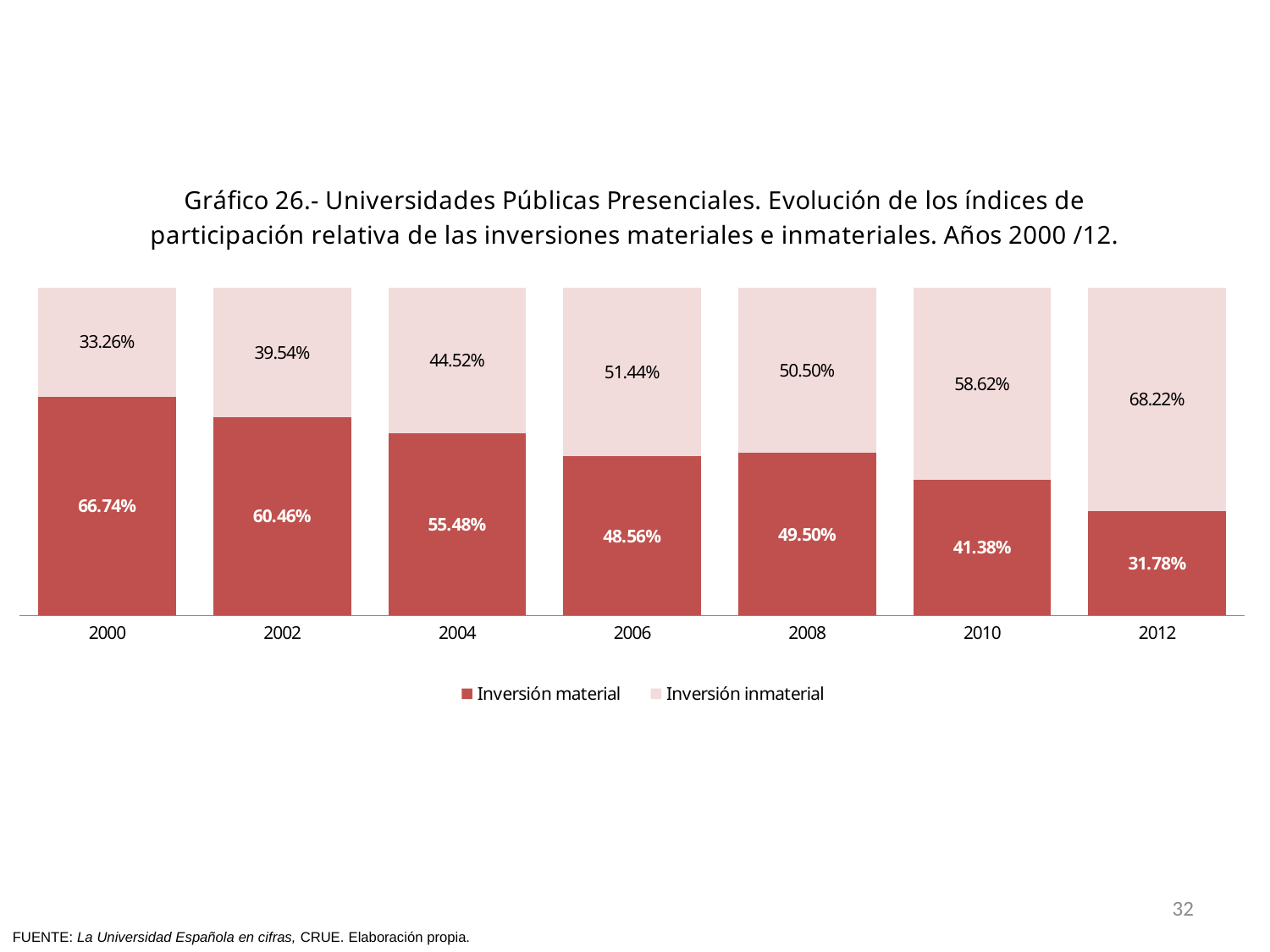
How many series does the legend list? 2 Which is larger in 2006, Inversión material or Inversión inmaterial? Inversión inmaterial What is the total of the stacked bar for 2010? 100.00% What is the difference between Inversión material in 2000 and in 2012? 34.96% What is the value of Inversión inmaterial for 2012? 68.22% In which year is Inversión inmaterial lowest? 2000 What is the value of Inversión material for 2008? 49.50% How many years are shown on the x axis? 7 What is the value of Inversión material for 2000? 66.74% In which year is Inversión material highest? 2000 What kind of chart is this? Stacked bar chart Does Inversión inmaterial generally rise or fall from 2000 to 2012? Rise